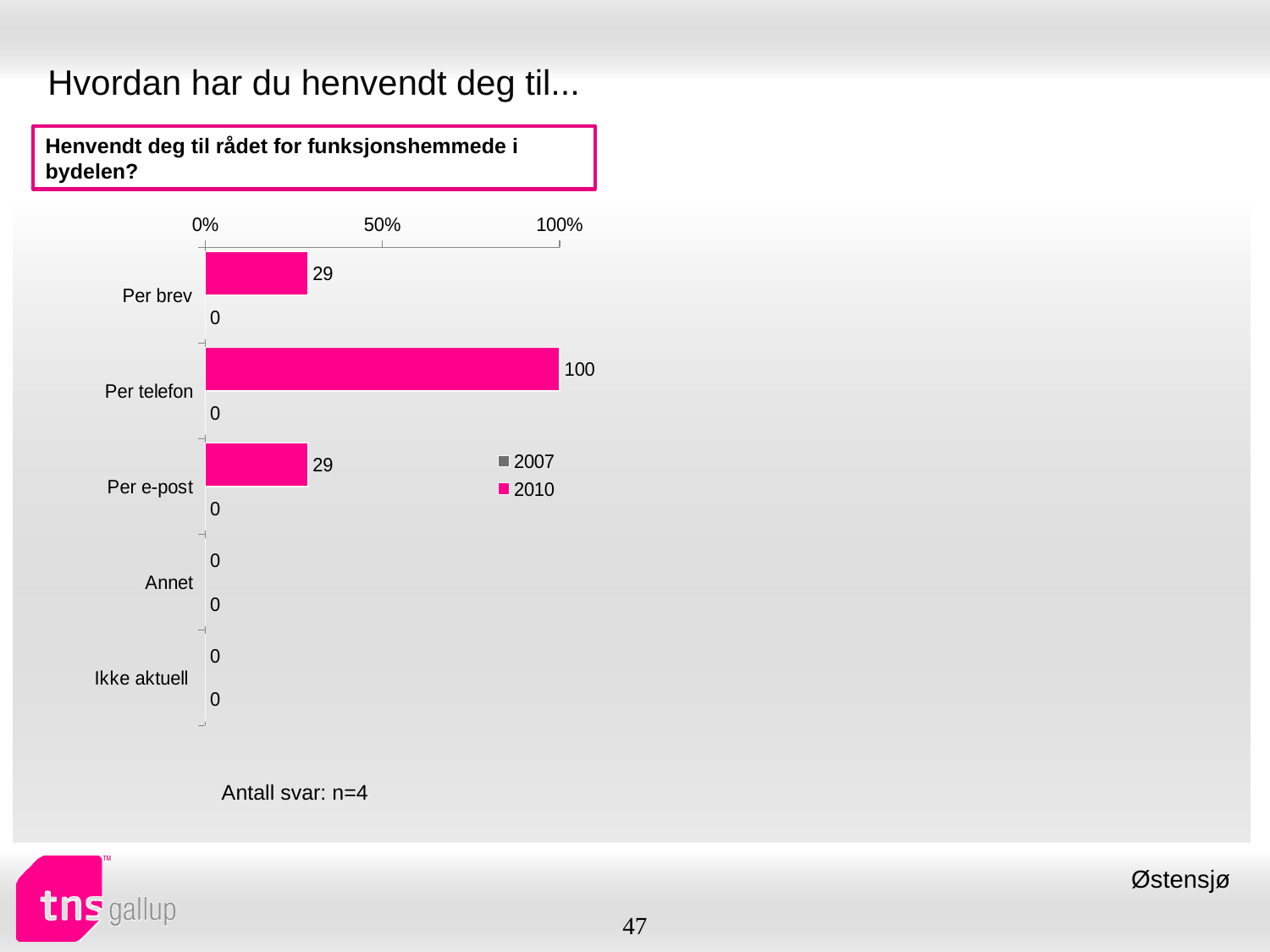
What is the 2010 value for Per telefon? 100 How many series does the legend list? 2 Which is larger, the 2010 value for Per telefon or the 2010 value for Per e-post? Per telefon What is the 2010 value for Per brev? 29 What is the 2010 value for Per e-post? 29 What is the 2010 value for Annet? 0 What is the difference between the 2010 values for Per telefon and Per brev? 71 What is the 2007 value for Per telefon? 0 Which category has the highest 2010 value? Per telefon Which colour represents the 2010 series in the legend? pink How many categories are shown on the chart? 5 What type of chart is shown on the slide? bar chart